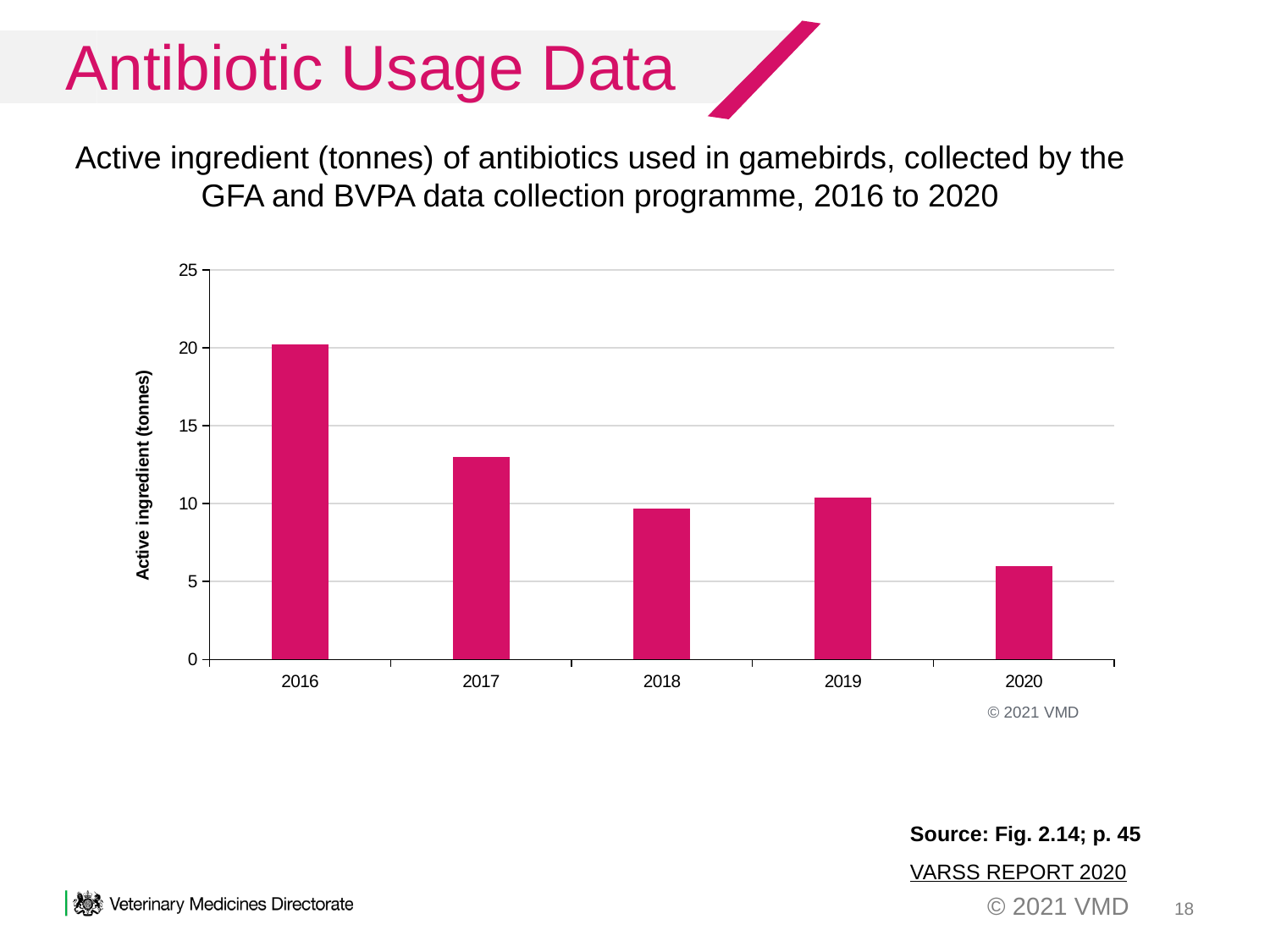
What is the label on the vertical axis of the chart? Active ingredient (tonnes) Do the values generally rise or fall from 2016 to 2020? fall What kind of chart is shown on the slide? bar chart Is the value for 2017 greater or less than 15? less How many years are plotted on the chart? 5 Is the value for 2020 greater or less than 10? less Which year has the highest active ingredient (tonnes) value? 2016 Which year has the lowest active ingredient (tonnes) value? 2020 Which year has the larger value, 2017 or 2020? 2017 Is the value for 2018 greater or less than 15? less Which year has the larger value, 2016 or 2017? 2016